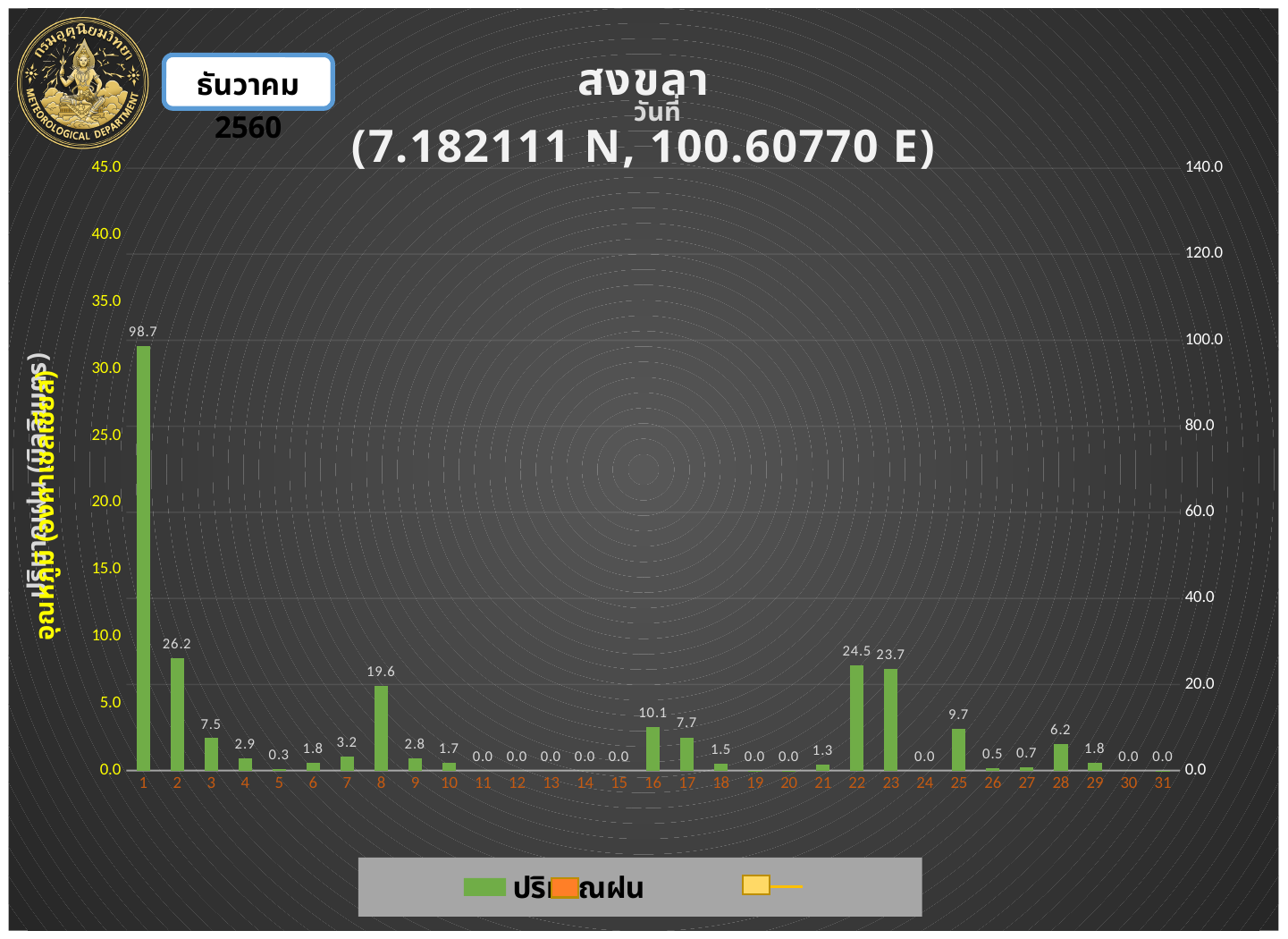
Is the value for day 1 greater or less than 80.0 on the right-hand axis? greater What is the difference between the values for day 2 and day 3? 18.7 What is the value labelled on the bar for day 8? 19.6 Which day has the highest bar in the chart? 1 What is the value shown for day 16? 10.1 What is the difference between the values for day 22 and day 23? 0.8 What is the value labelled on the bar for day 22? 24.5 How many days (categories) are shown along the x axis? 31 What coordinates are given in the chart title? 7.182111 N, 100.60770 E What kind of chart is shown on the slide? bar chart Which is larger, the value for day 8 or the value for day 25? day 8 What is the rainfall value shown for day 1? 98.7